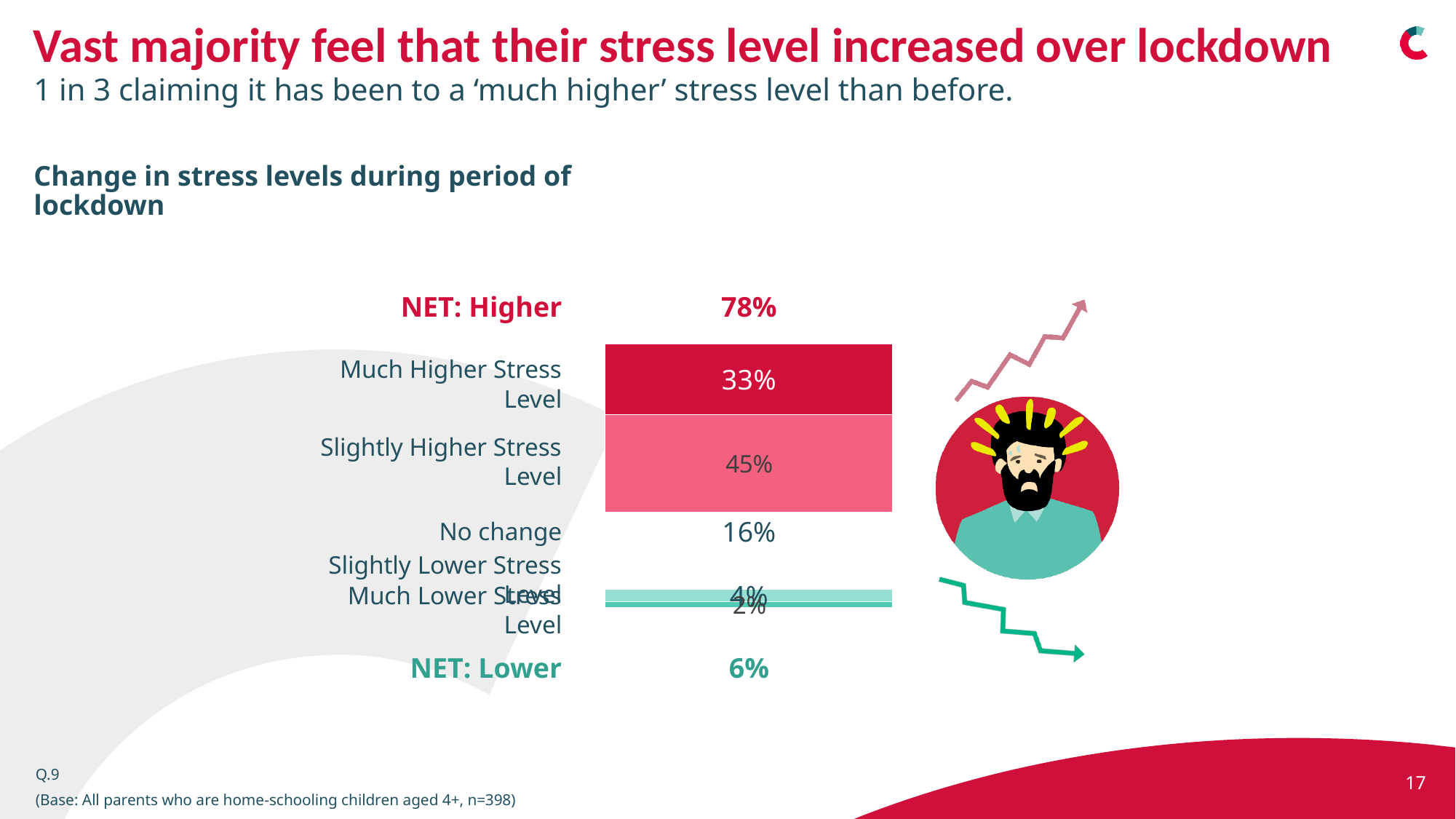
Which category has the lowest percentage? Much Lower Stress Level What is the difference between the 'Slightly Higher Stress Level' and 'Much Higher Stress Level' percentages? 12% What percentage of respondents reported a 'Slightly Higher Stress Level'? 45% What percentage of respondents reported a 'Much Higher Stress Level'? 33% What is the NET: Lower figure shown on the chart? 6% What percentage of respondents reported 'No change' in stress level? 16% What is the difference between the NET: Higher and NET: Lower figures? 72% What type of chart is used to show the change in stress levels? Bar chart Which category has the highest percentage? Slightly Higher Stress Level What is the NET: Higher figure shown on the chart? 78% What is the title of the chart? Change in stress levels during period of lockdown Which is larger: the percentage for 'Much Higher Stress Level' or for 'No change'? Much Higher Stress Level